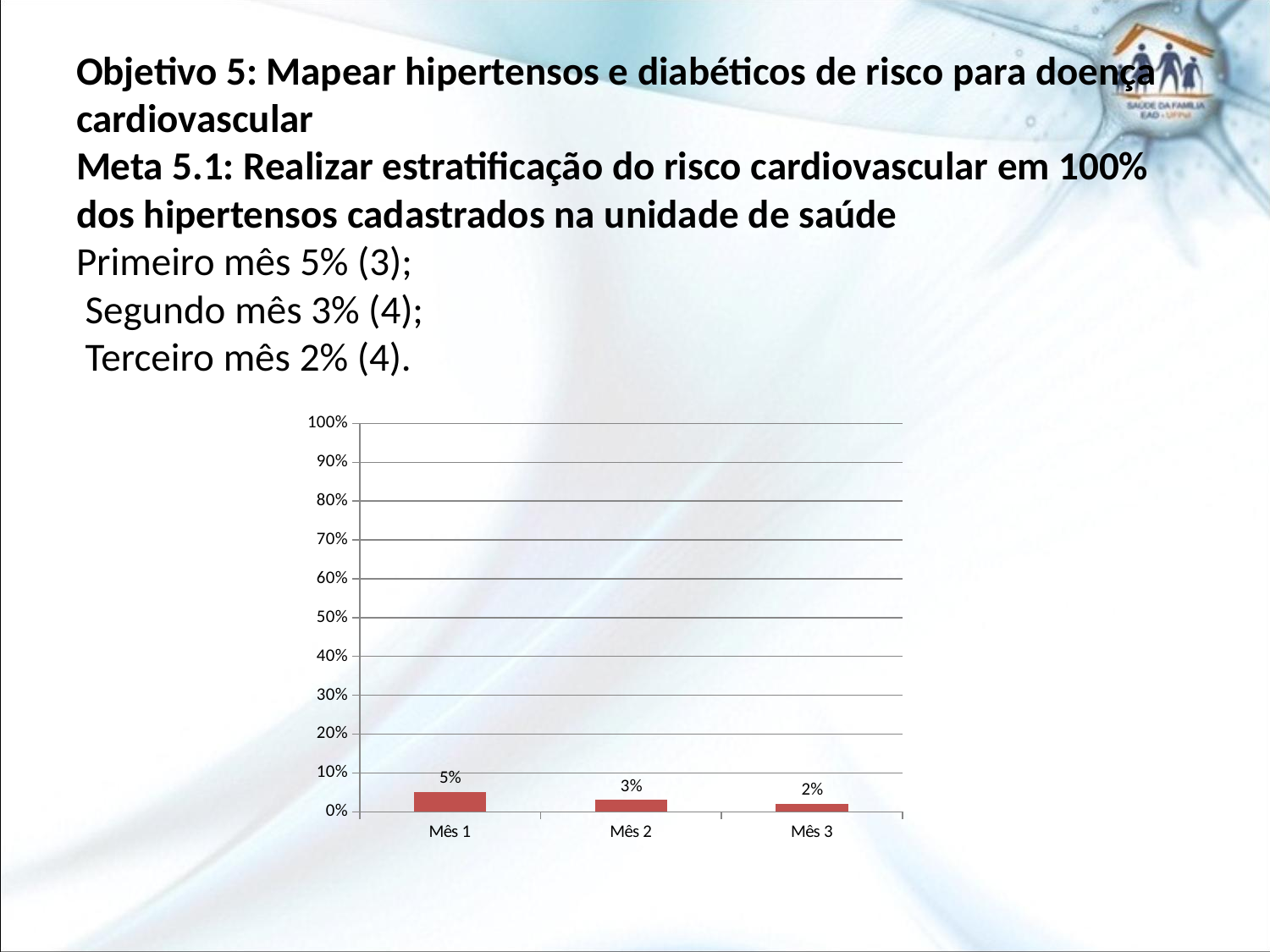
What is the difference between the values for Mês 1 and Mês 3? 3% Which month has the lowest value? Mês 3 How many categories are shown on the x axis? 3 Is the value for Mês 1 greater or less than 10%? less Which is larger, the value for Mês 2 or the value for Mês 3? Mês 2 What is the value for Mês 3? 2% What kind of chart is shown on the slide? bar chart What is the difference between the values for Mês 1 and Mês 2? 2% Do the values rise or fall from Mês 1 to Mês 3? fall What is the value for Mês 1? 5% Which month has the highest value? Mês 1 What is the value for Mês 2? 3%